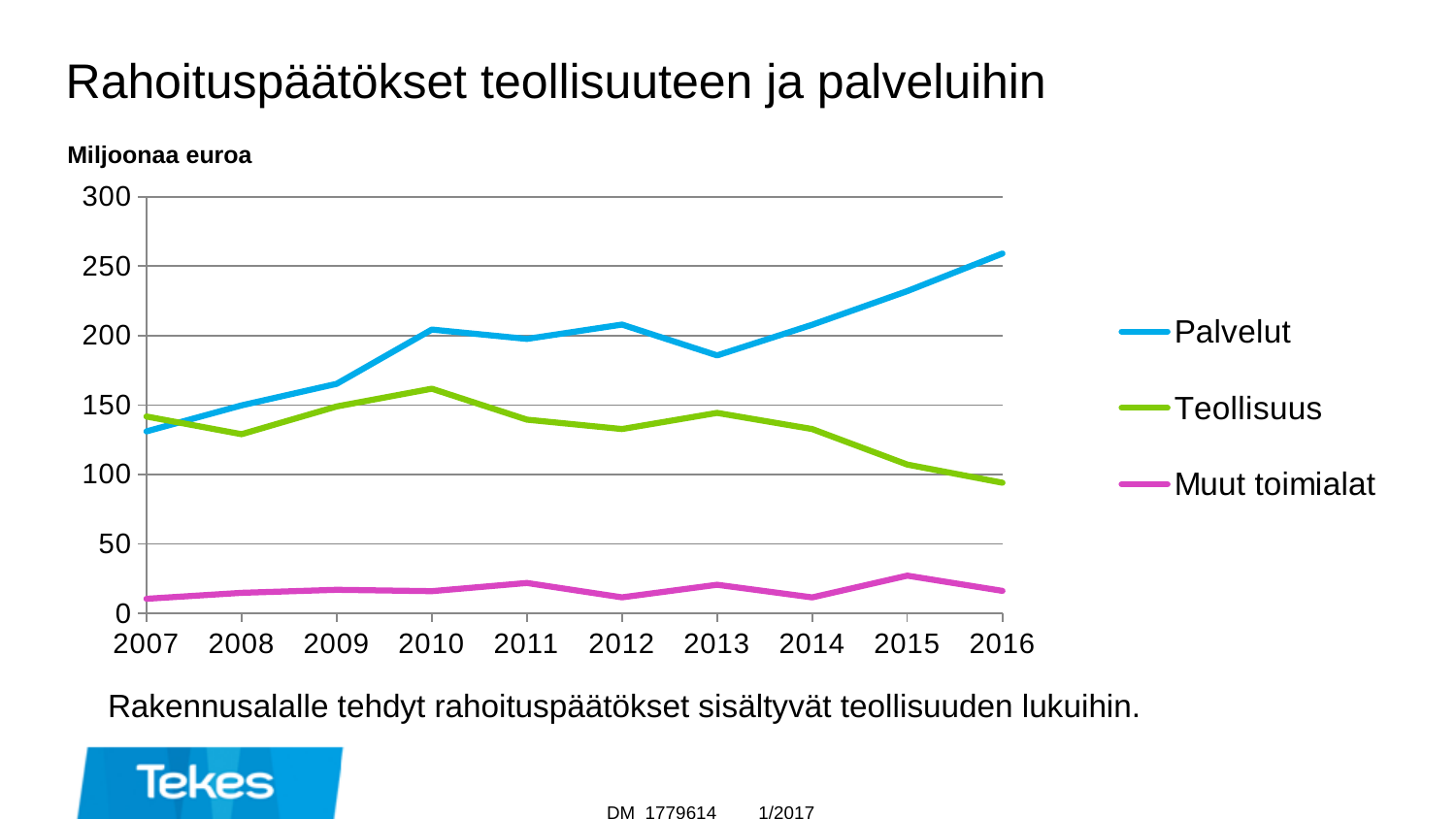
Does the Teollisuus series rise or fall from 2010 to 2016? fall How many years are shown on the x axis? 10 In which year is the Palvelut series at its highest? 2016 In 2016, which is larger: Palvelut or Teollisuus? Palvelut In which year is the Muut toimialat series at its highest? 2015 In which year is the Teollisuus series at its lowest? 2016 Is the value for Teollisuus in 2016 greater or less than 150? less What unit is given above the y axis? Miljoonaa euroa Is the value for Palvelut in 2016 greater or less than 200? greater How many series does the legend list? 3 Is the value for Muut toimialat in 2015 greater or less than 50? less What kind of chart is shown on the slide? line chart